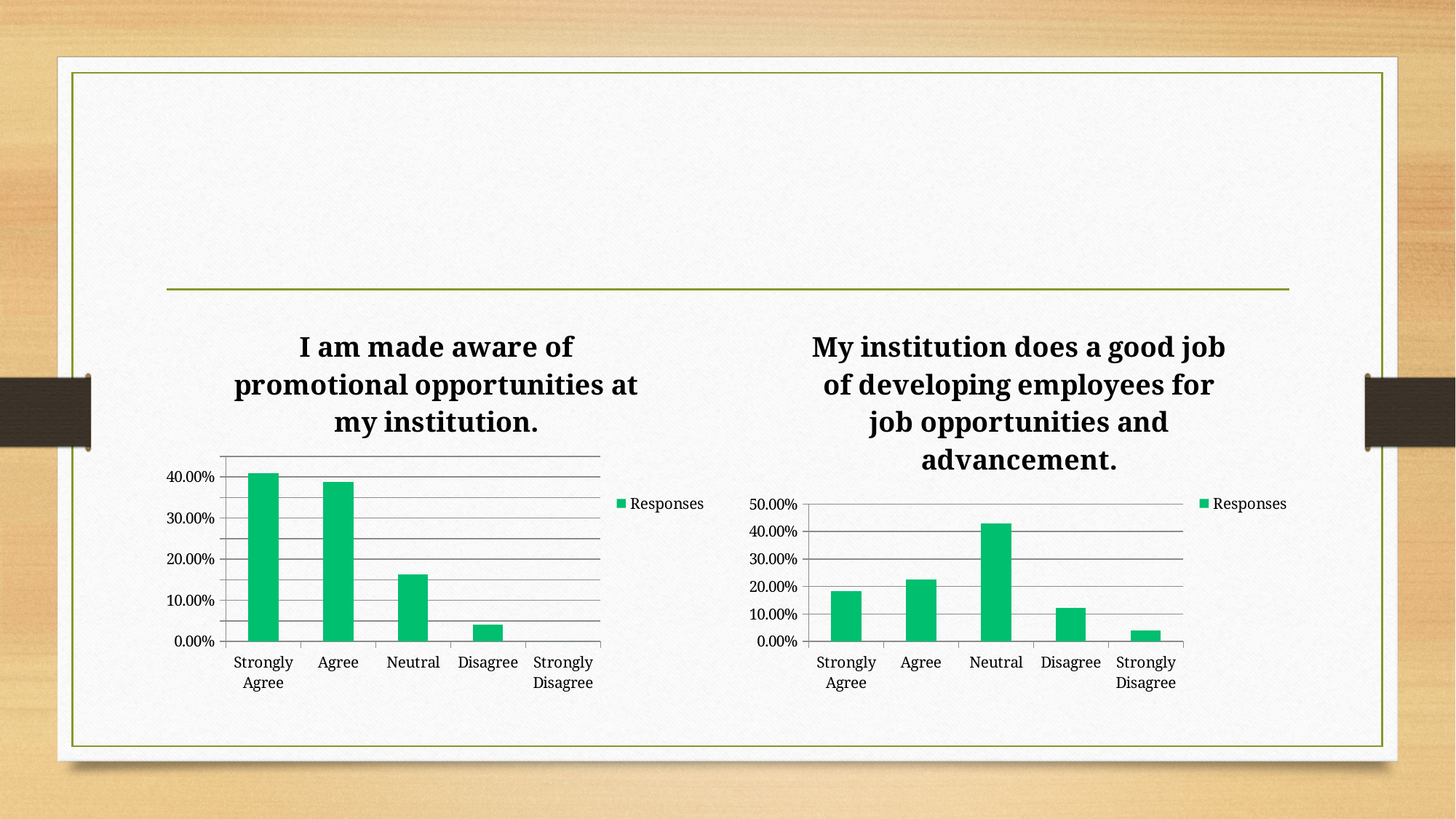
In the chart titled "My institution does a good job of developing employees for job opportunities and advancement.", which category has the lowest value? Strongly Disagree What kind of chart is the chart titled "I am made aware of promotional opportunities at my institution."? bar chart In the chart titled "I am made aware of promotional opportunities at my institution.", how many response categories are shown on the x axis? 5 In the chart titled "My institution does a good job of developing employees for job opportunities and advancement.", which category has the highest value? Neutral In the chart titled "I am made aware of promotional opportunities at my institution.", which is larger, the value for Agree or the value for Neutral? Agree How many series does the legend list in the chart titled "My institution does a good job of developing employees for job opportunities and advancement."? 1 In the chart titled "I am made aware of promotional opportunities at my institution.", do the values rise or fall from Strongly Agree to Strongly Disagree? fall In the chart titled "I am made aware of promotional opportunities at my institution.", which category has the lowest value? Strongly Disagree In the chart titled "My institution does a good job of developing employees for job opportunities and advancement.", which is larger, the value for Agree or the value for Disagree? Agree In the chart titled "My institution does a good job of developing employees for job opportunities and advancement.", is the value for Neutral greater or less than 40.00%? greater In the chart titled "I am made aware of promotional opportunities at my institution.", is the value for Neutral greater or less than 20.00%? less